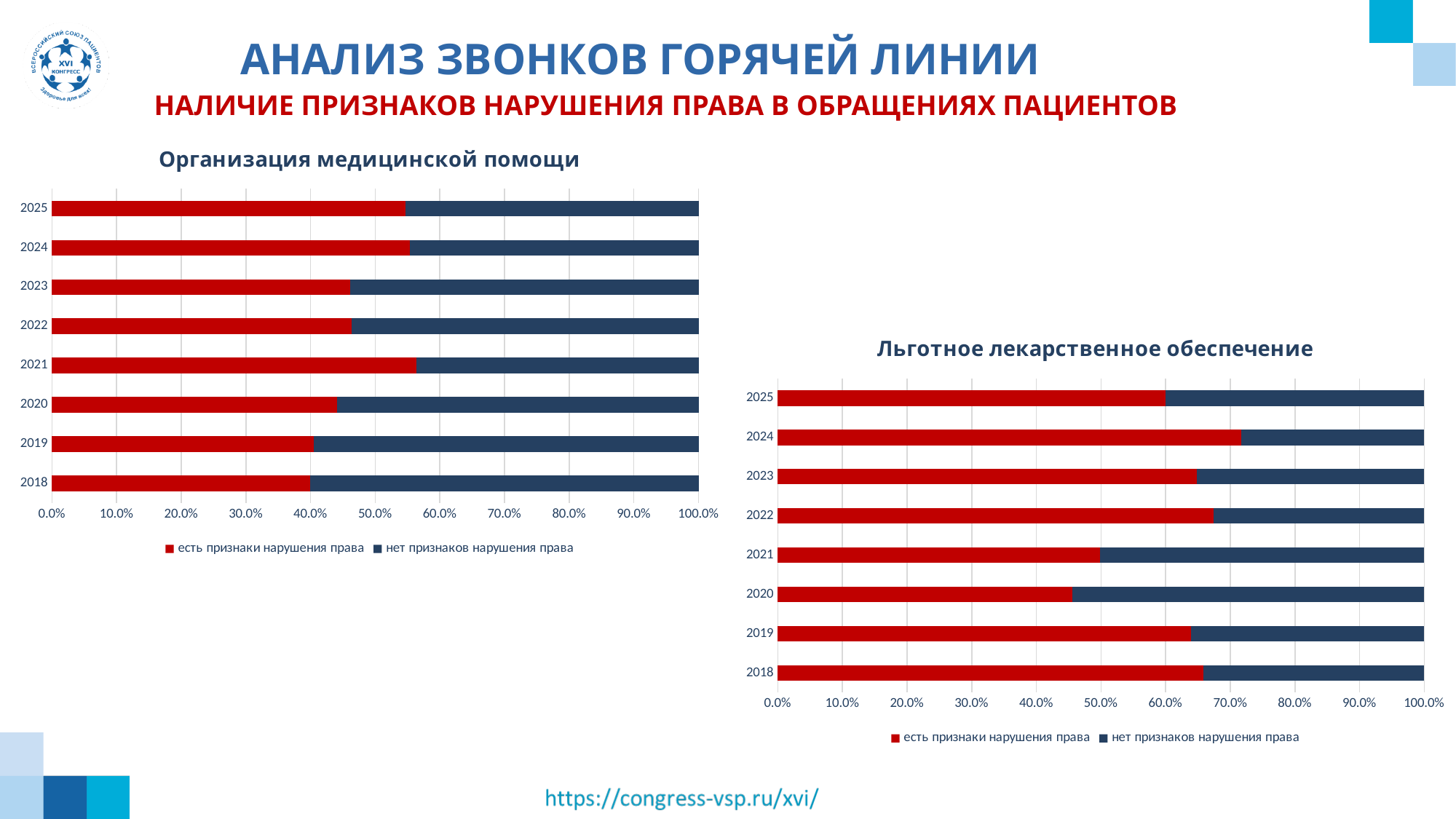
How many years are shown on the "Организация медицинской помощи" chart? 8 In the "Организация медицинской помощи" chart, is the share of "есть признаки нарушения права" for 2018 greater or less than 50.0%? less In the "Организация медицинской помощи" chart, is the share of "есть признаки нарушения права" for 2021 greater or less than 50.0%? greater Which colour represents "нет признаков нарушения права" in the charts? Dark blue In the "Льготное лекарственное обеспечение" chart, is the share of "есть признаки нарушения права" for 2024 greater or less than 70.0%? greater In the "Льготное лекарственное обеспечение" chart, which year has the lowest share of "есть признаки нарушения права"? 2020 What kind of chart is the "Организация медицинской помощи" chart? Stacked bar chart In the "Льготное лекарственное обеспечение" chart, which year has the highest share of "есть признаки нарушения права"? 2024 In the "Льготное лекарственное обеспечение" chart, which year has a larger share of "есть признаки нарушения права": 2024 or 2021? 2024 How many series does the legend of the "Льготное лекарственное обеспечение" chart list? 2